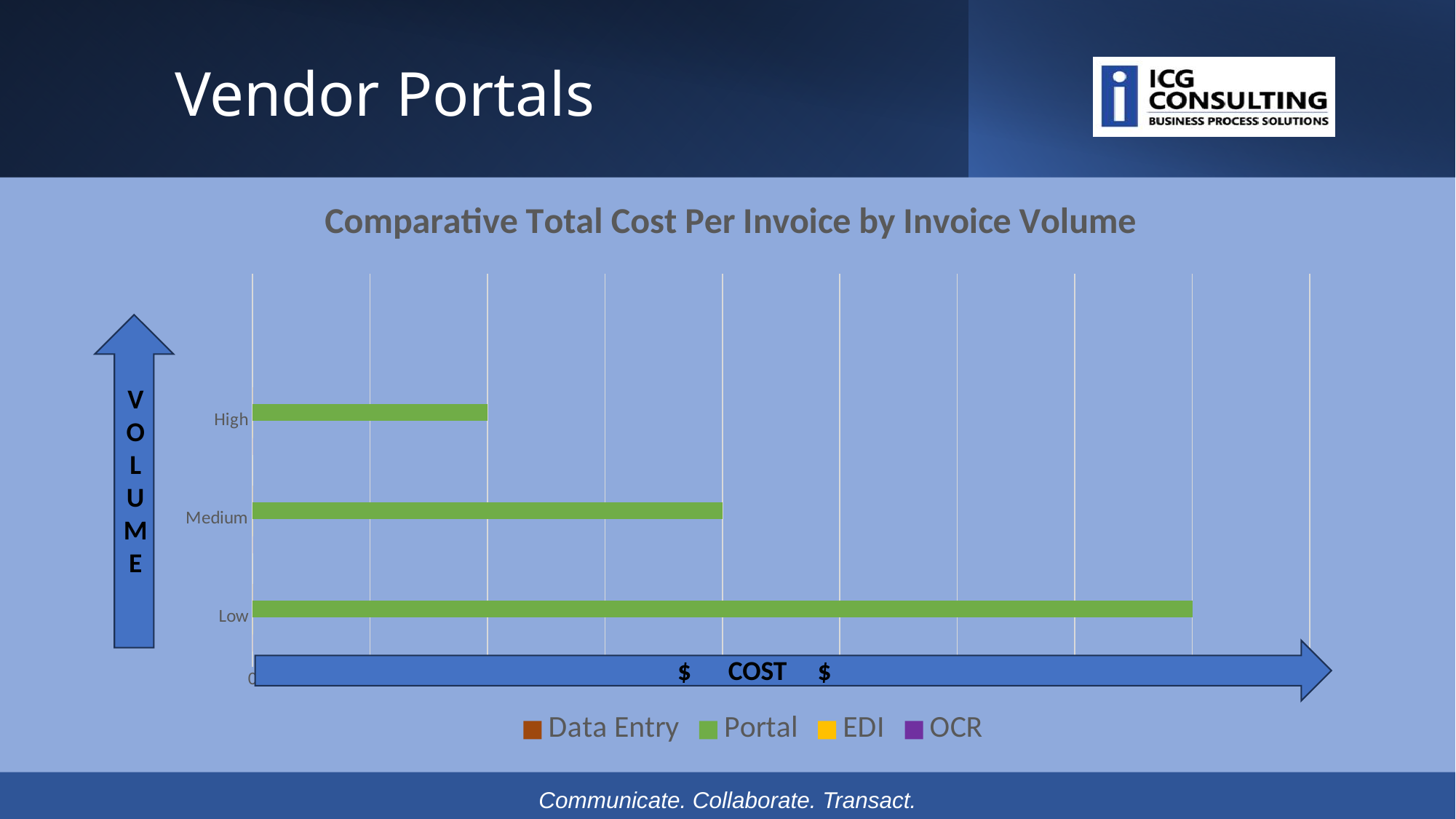
What kind of chart is shown on the slide? bar chart Which series is the only one with visible bars on the chart? Portal Which series are listed in the chart legend? Data Entry, Portal, EDI, OCR Which volume category has the shortest Portal bar? High How many volume categories are shown on the chart's vertical axis? 3 Is the Portal bar for Medium volume longer or shorter than the Portal bar for High volume? longer Which volume category has the longest Portal bar? Low How many series does the chart legend list? 4 Is the Portal bar for Low volume longer or shorter than the Portal bar for Medium volume? longer Do the Portal bars get longer or shorter as volume goes from Low to High? shorter What is the title of the chart? Comparative Total Cost Per Invoice by Invoice Volume